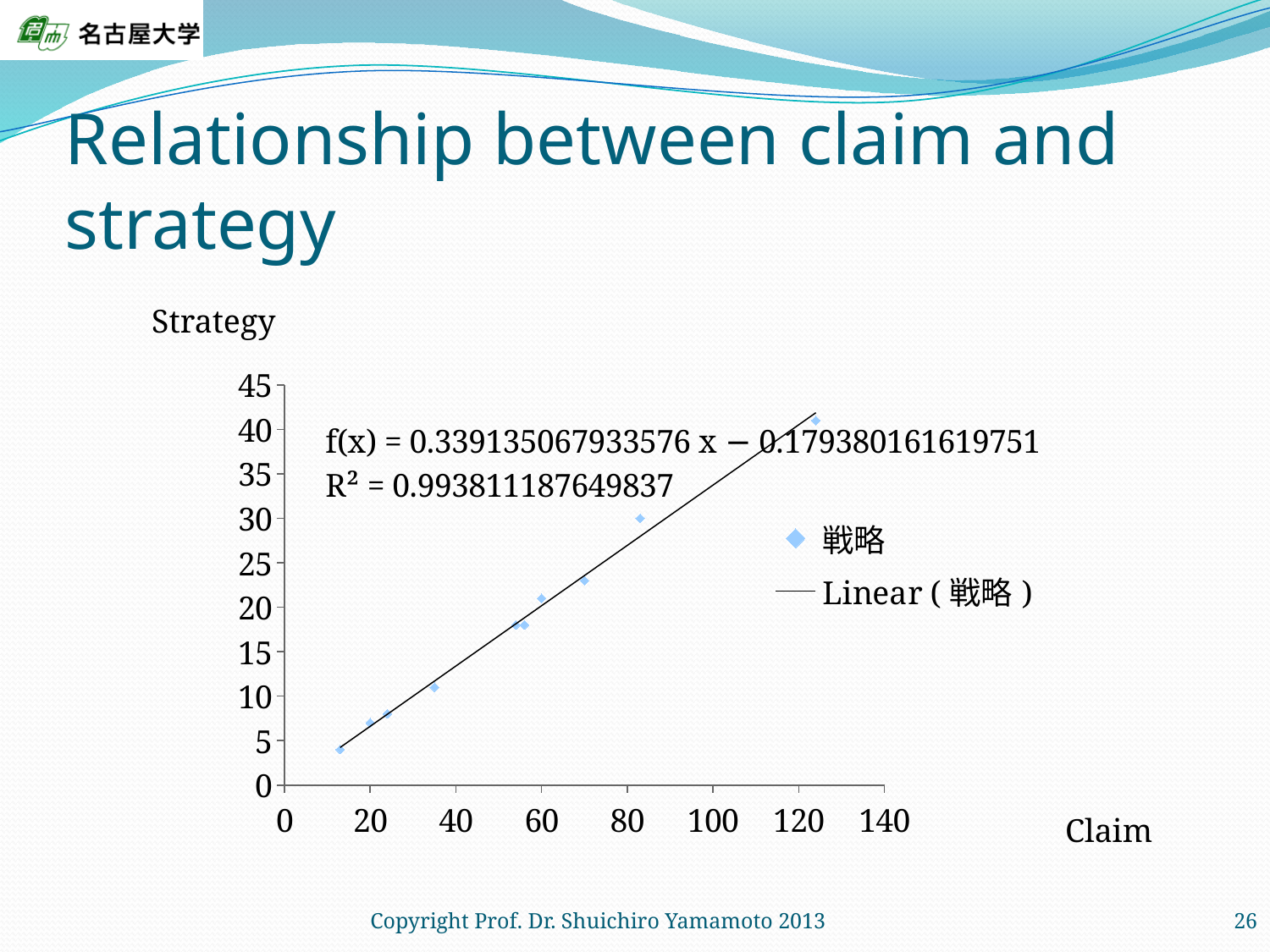
Is the Strategy value of the point at Claim ≈ 35 greater or less than 10? greater What kind of chart is shown on the slide? scatter chart What is the slope of the fitted line f(x) shown on the chart? 0.339135067933576 How many entries does the chart legend list? 2 What is the highest tick value shown on the x axis? 140 What is the R² value printed on the chart? 0.993811187649837 Is the Claim value of the point with the highest Strategy greater or less than 120? greater Is the Strategy value of the point at Claim ≈ 70 greater or less than 20? greater What is the name of the trendline entry in the legend? Linear (戦略) Do the Strategy values rise or fall as Claim increases along the x axis? rise What label is given to the vertical axis of the chart? Strategy